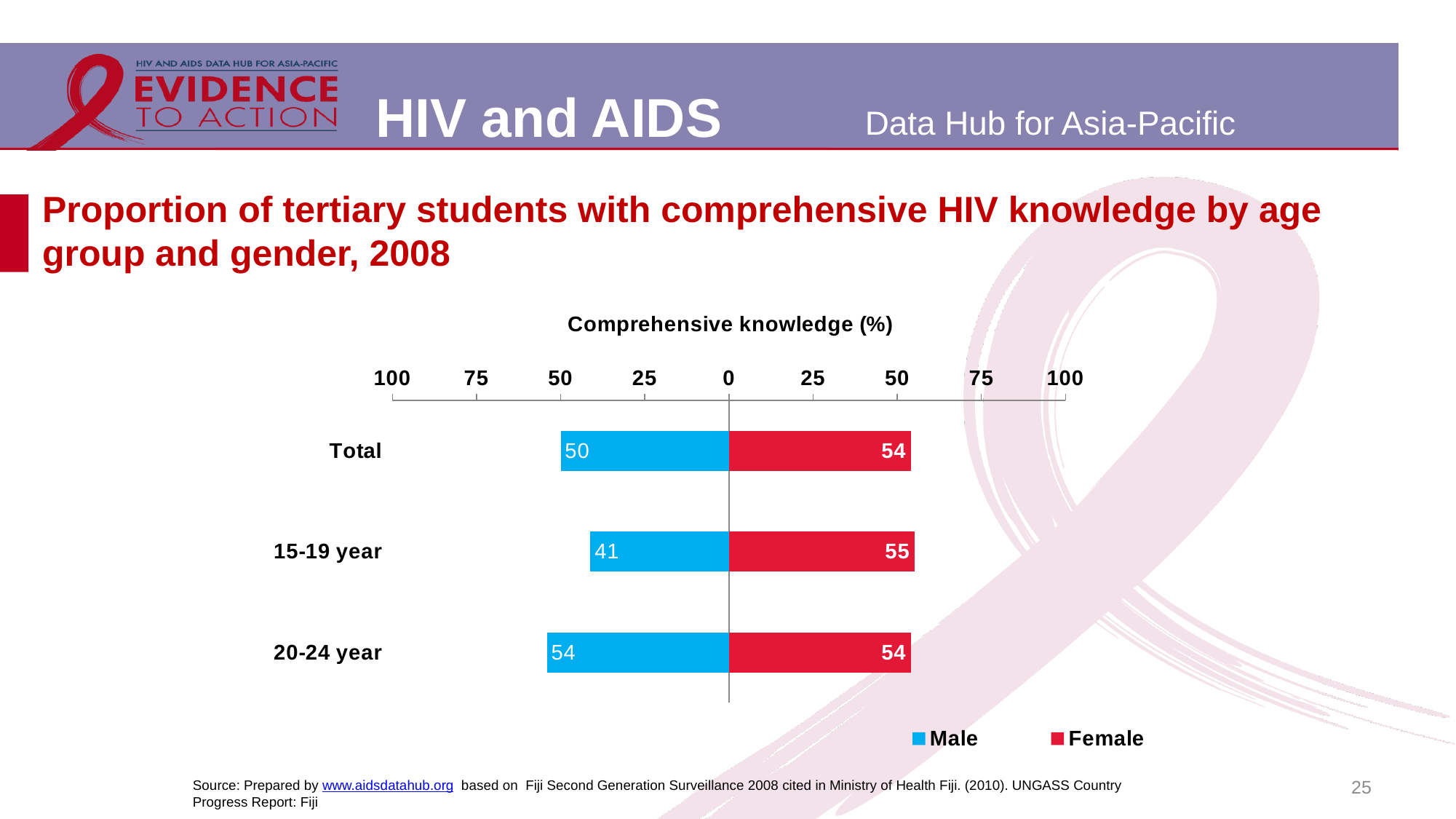
How many series does the legend list? 2 What is the difference between the Female and Male values for the 15-19 year age group? 14 What is the Female value for the Total category? 54 What kind of chart is shown on the slide? Bar chart What is the axis title shown above the chart? Comprehensive knowledge (%) What is the difference between the Female and Male values for the Total category? 4 What is the Male value for the 20-24 year age group? 54 For the Total category, which is larger, the Male value or the Female value? Female How many categories are shown on the chart? 3 What is the Male value for the 15-19 year age group? 41 What is the Female value for the 15-19 year age group? 55 Which age group has the lowest Male value? 15-19 year